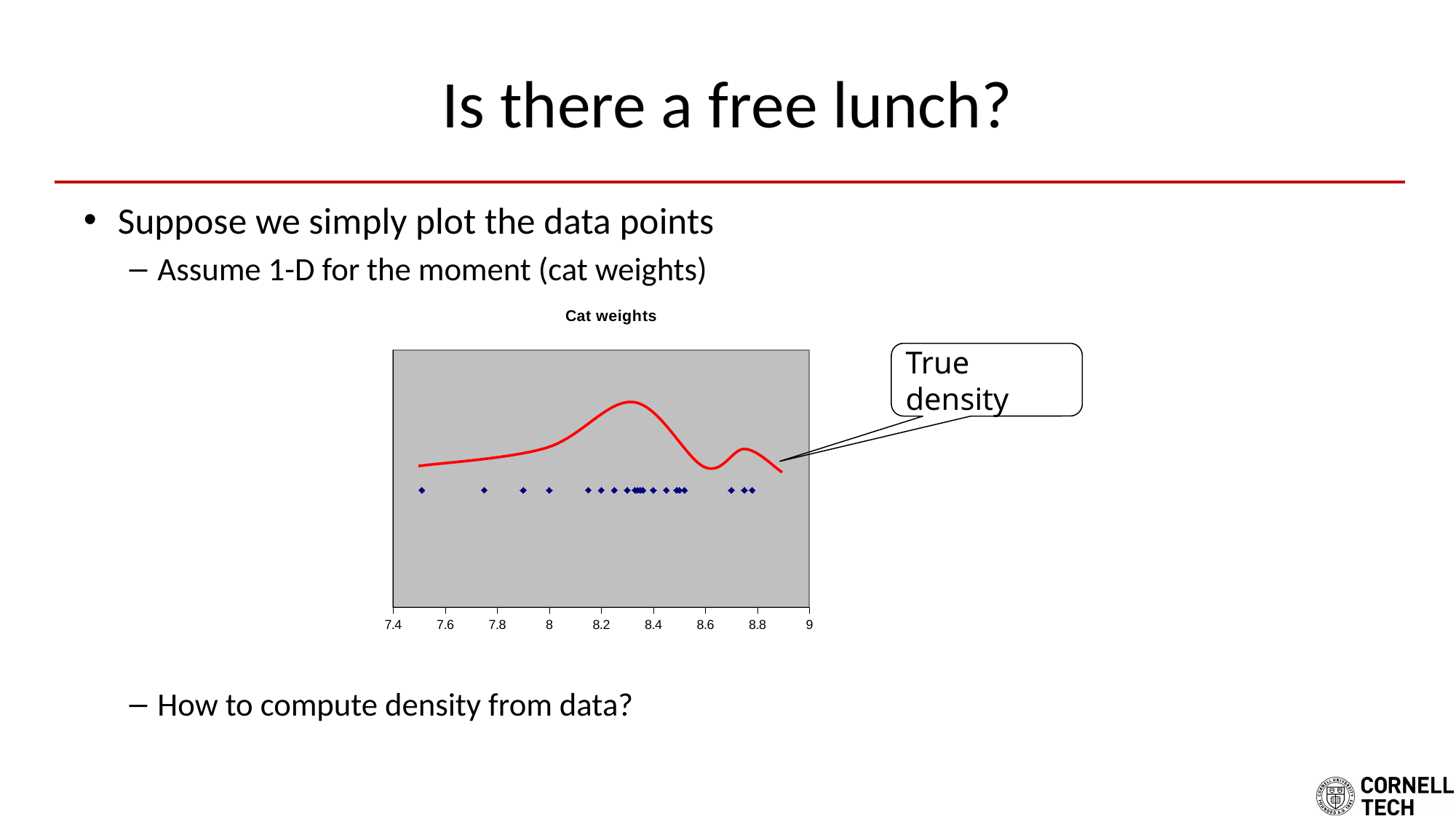
Is the x value of the leftmost data point greater or less than 7.6? less What kind of chart is shown on the slide? scatter chart Does the red density curve rise or fall between x = 7.4 and x = 8.2? rise What is the highest value shown on the x axis of the chart? 9 Is the x value of the rightmost data point greater or less than 8.6? greater Is the x position of the highest peak of the red density curve greater or less than 8.6? less Does the red density curve rise or fall between x = 8.4 and x = 8.6? fall How many tick labels are shown on the x axis of the chart? 9 What is the title of the chart? Cat weights What does the callout label the red curve on the chart as? True density What is the lowest value shown on the x axis of the chart? 7.4